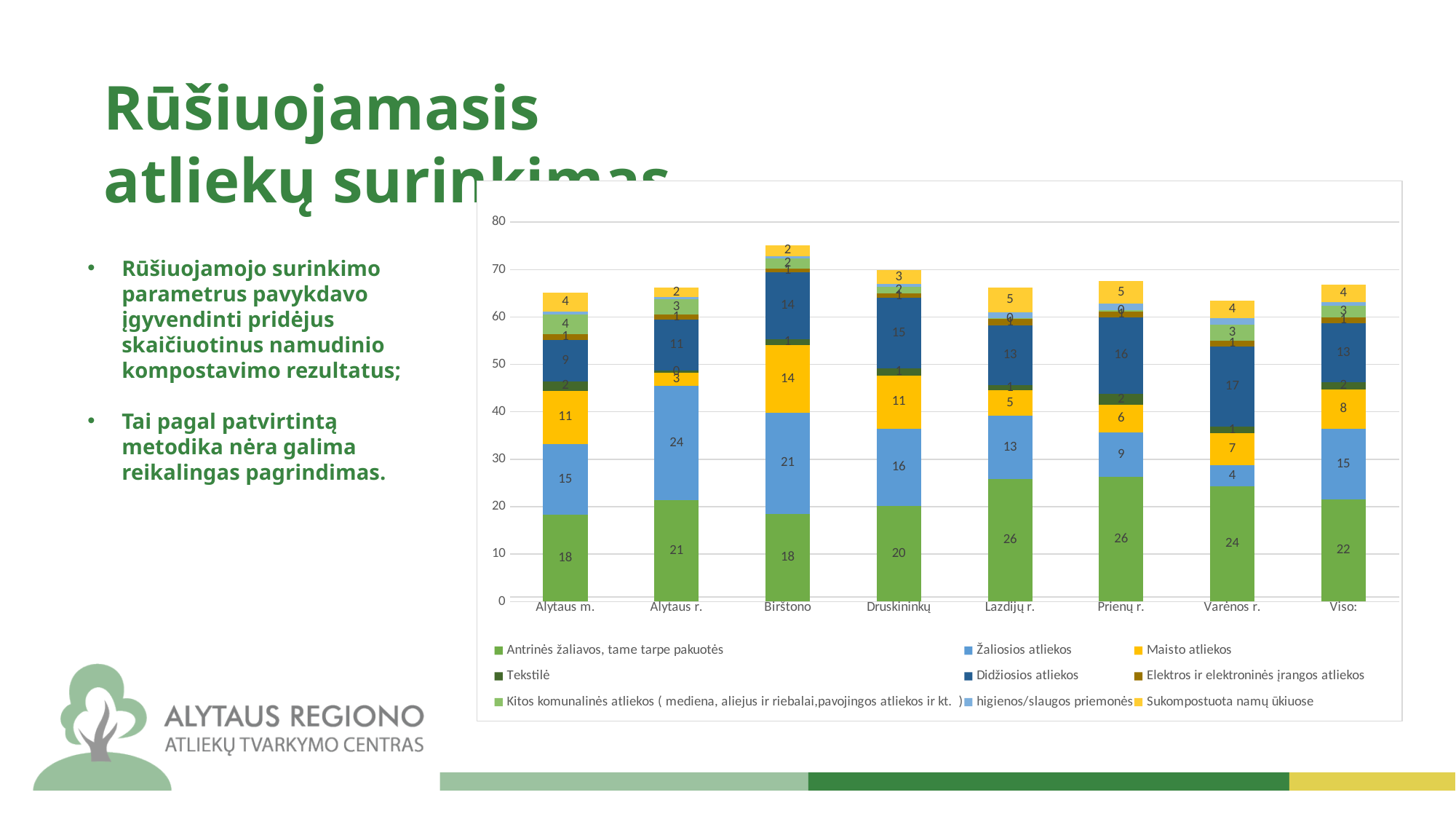
What is the value of Žaliosios atliekos for Alytaus r.? 24 What is the value of Maisto atliekos for Birštono? 14 What is the value of Antrinės žaliavos, tame tarpe pakuotės for Lazdijų r.? 26 Which category has the highest value for Žaliosios atliekos? Alytaus r. How many series does the legend list? 9 Which category has the lowest value for Didžiosios atliekos? Alytaus m. Is the total height of the Birštono bar greater or less than 70? greater What is the value of Didžiosios atliekos for Viso:? 13 What kind of chart is shown on the slide? Stacked bar chart Which has the larger Maisto atliekos value, Birštono or Prienų r.? Birštono What is the difference between the Žaliosios atliekos values for Alytaus r. and Varėnos r.? 20 How many categories are shown on the x axis? 8